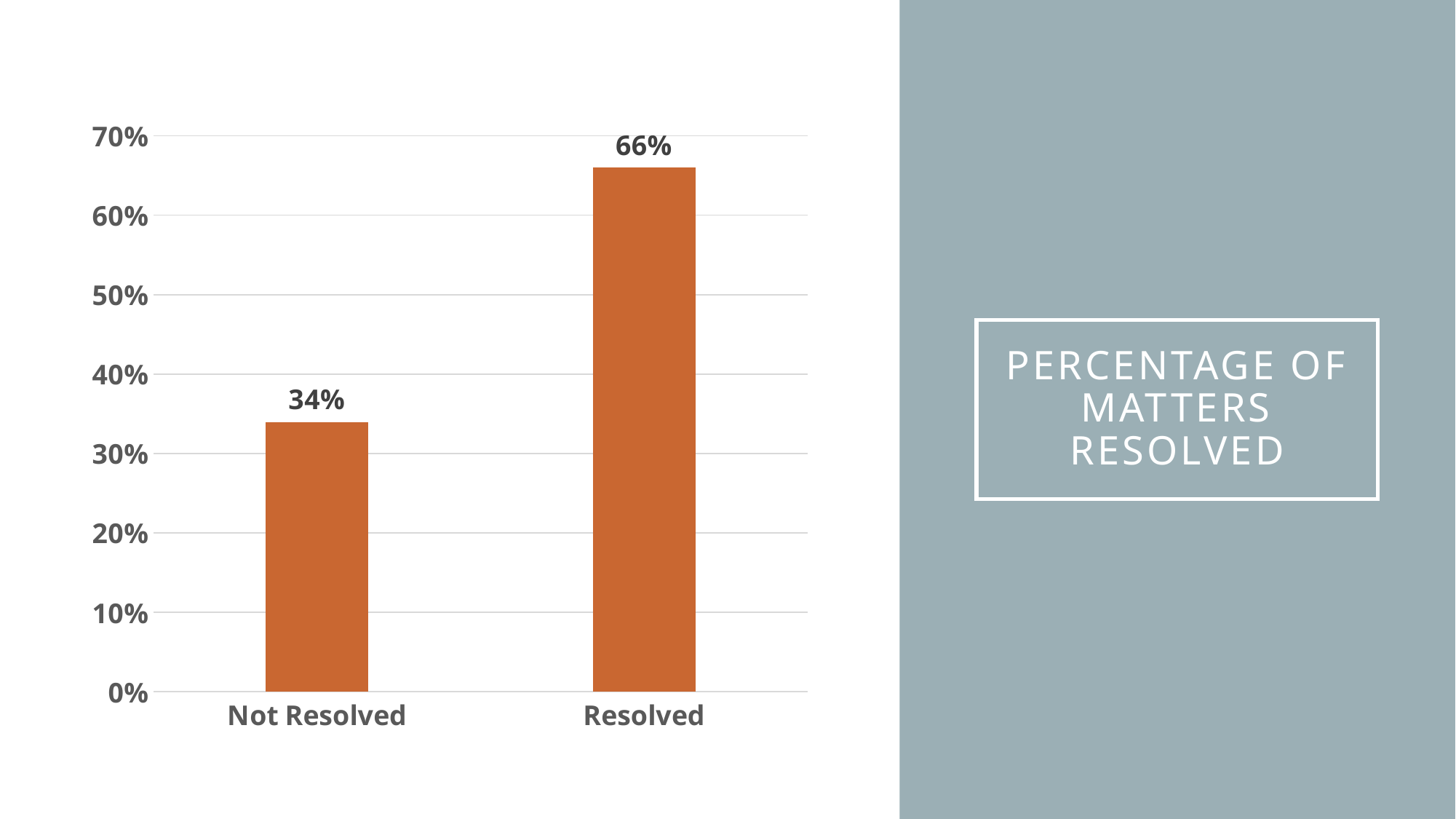
Is the value for Resolved greater or less than 60%? greater What is the title shown on the slide for the chart? Percentage of Matters Resolved Which category has the lowest value? Not Resolved What is the value for Resolved? 66% Which category has the highest value? Resolved Which is larger, the value for Resolved or the value for Not Resolved? Resolved How many categories are shown on the chart? 2 What is the value for Not Resolved? 34% Is the value for Not Resolved greater or less than 40%? less What is the highest value shown on the vertical axis? 70% What kind of chart is shown on the slide? Bar chart What is the difference between the Resolved and Not Resolved values? 32%